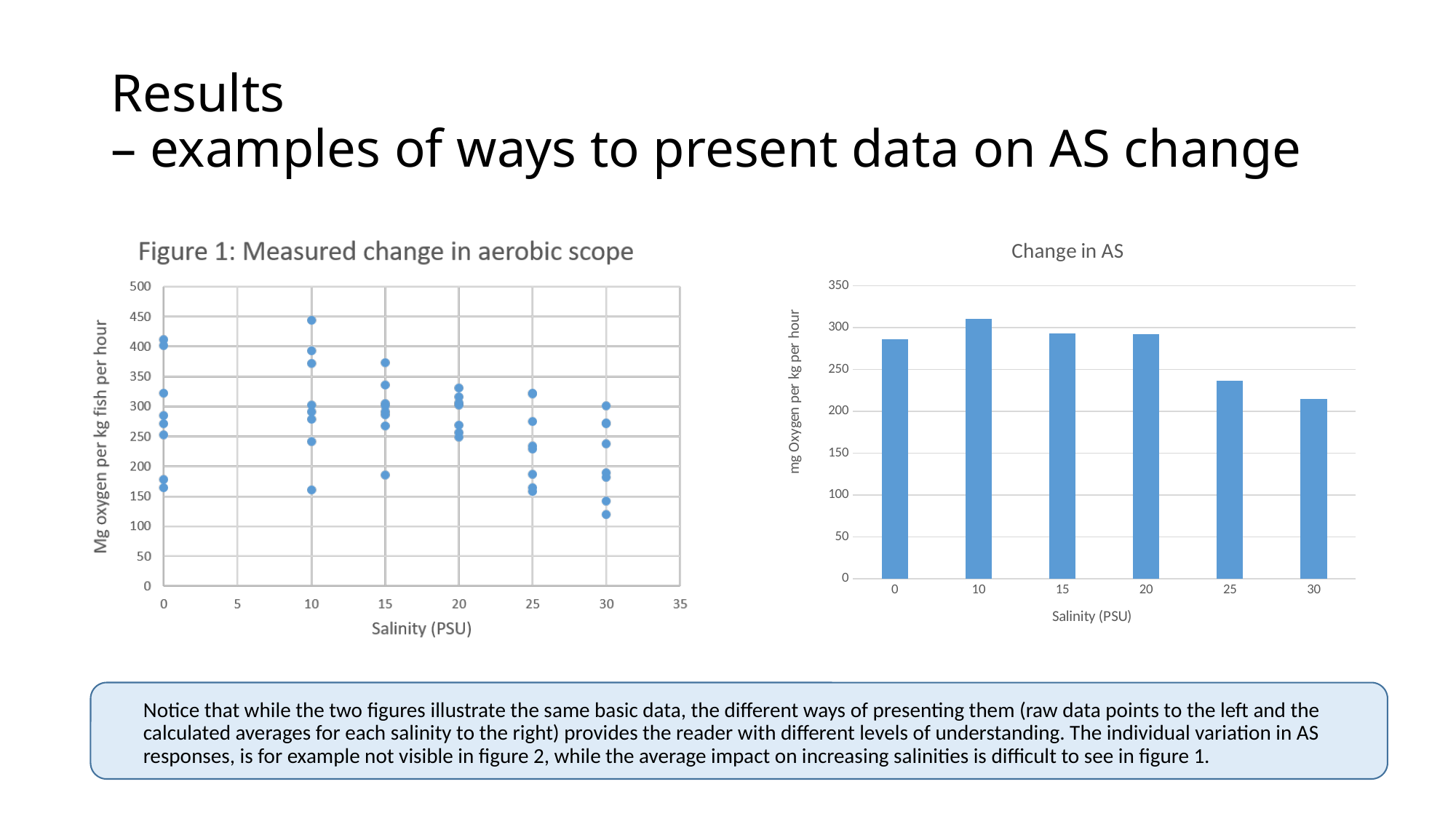
In the "Change in AS" chart, which salinity has the highest bar? 10 In the "Change in AS" chart, which is larger, the bar for salinity 10 or the bar for salinity 25? 10 In the "Change in AS" chart, do the bars generally rise or fall from salinity 10 to salinity 30? fall In the "Change in AS" chart, which salinity has the lowest bar? 30 How many bars are shown in the "Change in AS" chart? 6 In the "Change in AS" chart, is the bar for salinity 25 greater or less than 250? less In the "Change in AS" chart, is the bar for salinity 10 greater or less than 300? greater In the "Change in AS" chart, is the bar for salinity 30 greater or less than 250? less What is the x-axis label of the "Change in AS" chart? Salinity (PSU) What is the y-axis label of "Figure 1: Measured change in aerobic scope"? Mg oxygen per kg fish per hour What kind of chart is the chart titled "Change in AS" on the right? bar chart What kind of chart is "Figure 1: Measured change in aerobic scope" on the left? scatter chart